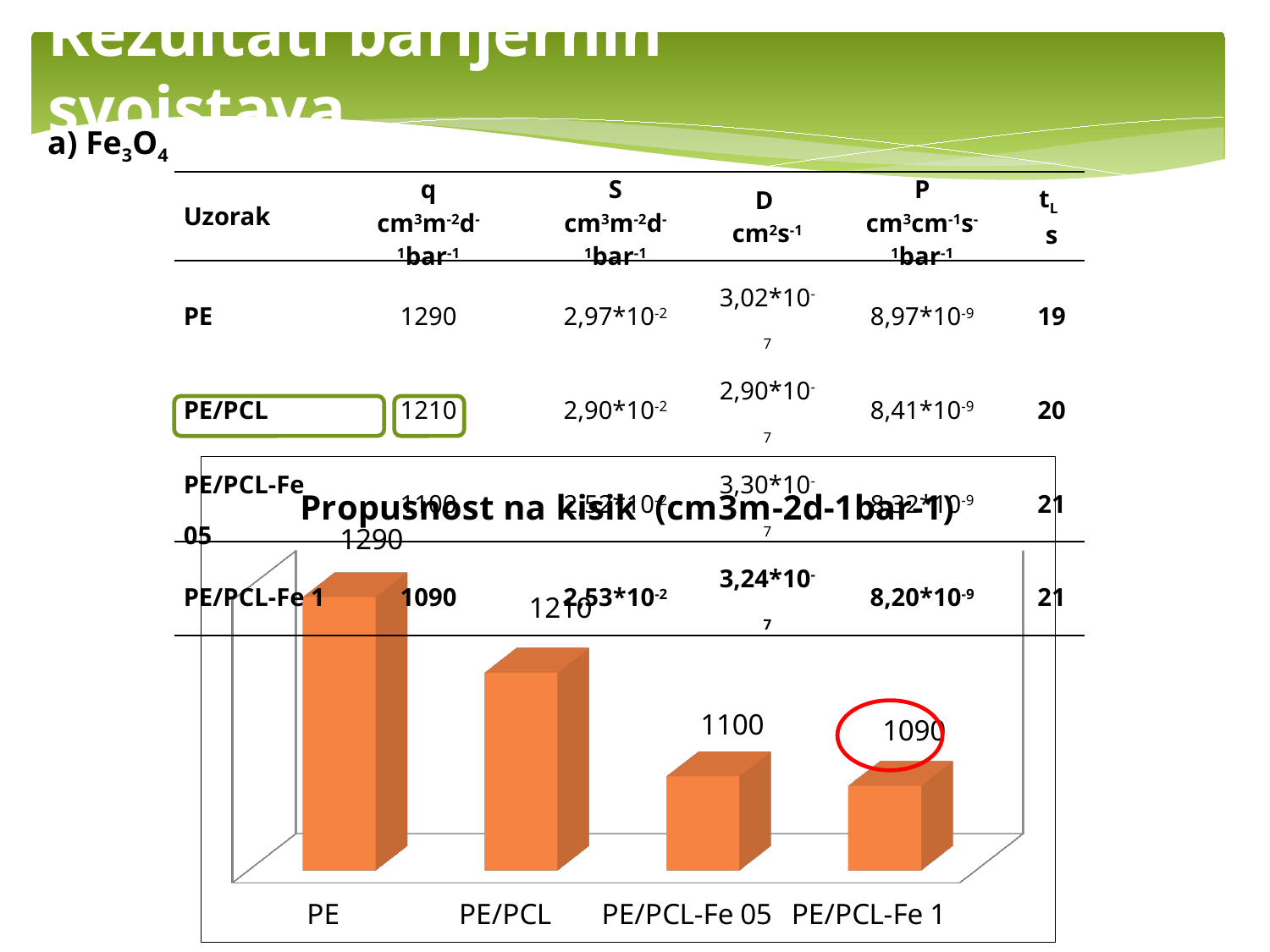
What kind of chart is shown on the slide? bar chart Which category has the highest value in the chart? PE What is the value for PE/PCL-Fe 05 in the chart? 1100 Which is larger, the value for PE or the value for PE/PCL? PE Do the values rise or fall from left to right across the categories? fall What is the value for PE/PCL in the chart? 1210 Which category has the lowest value in the chart? PE/PCL-Fe 1 What is the value for PE in the chart? 1290 What is the difference between the values for PE/PCL and PE/PCL-Fe 05? 110 What is the difference between the values for PE and PE/PCL-Fe 1? 200 How many categories are shown in the chart? 4 What is the value for PE/PCL-Fe 1 in the chart? 1090